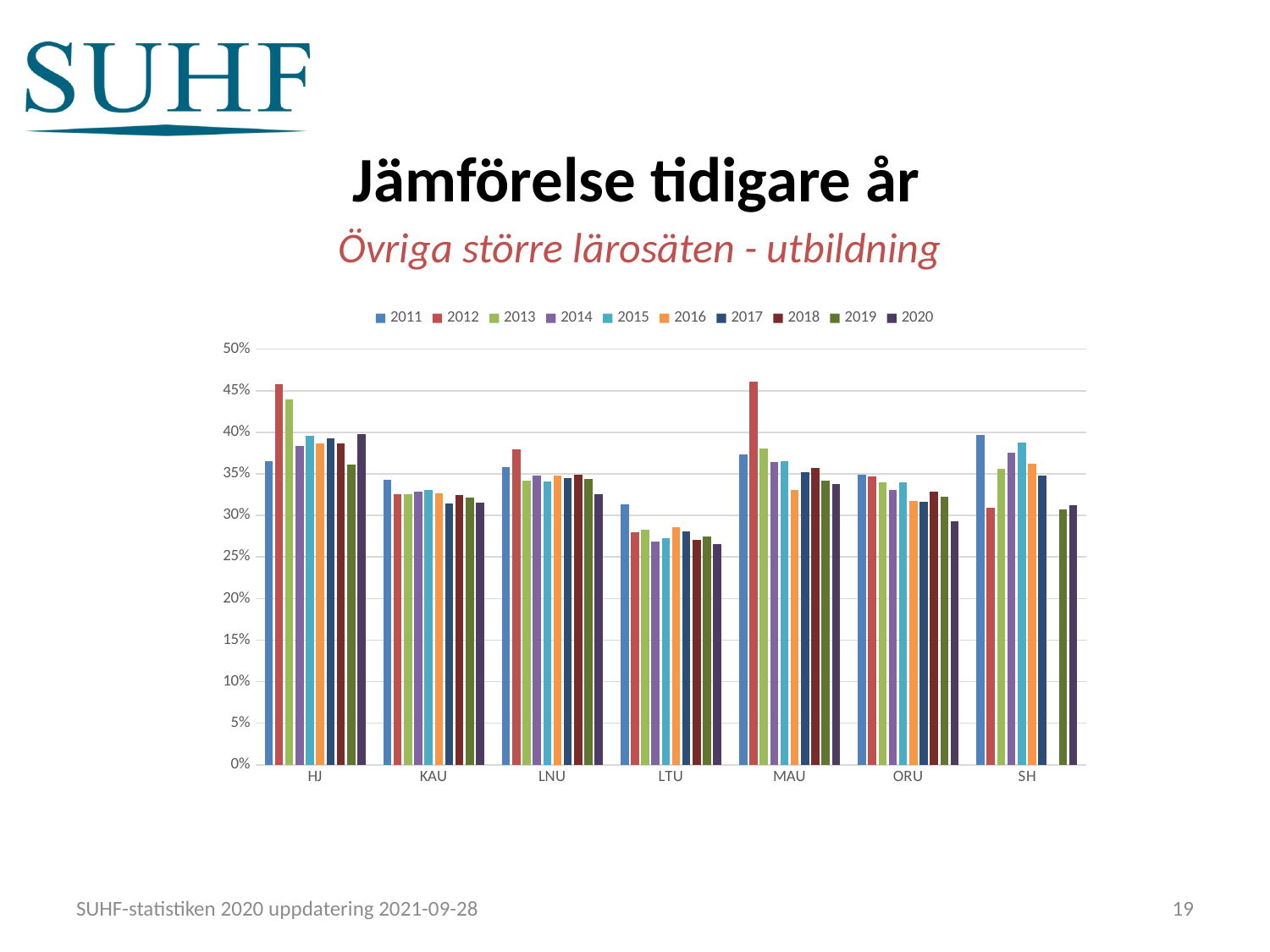
How many categories (lärosäten) are shown on the x axis of the chart? 7 For SH, which is larger: the 2011 value or the 2012 value? 2011 Is the value for LTU in 2011 greater or less than 30%? greater Is the value for MAU in 2012 greater or less than 45%? greater How many series does the chart legend list? 10 What is the subtitle shown in red italics above the chart? Övriga större lärosäten - utbildning Is the value for HJ in 2012 greater or less than 45%? greater Which category has the lowest value for 2020? LTU What kind of chart is shown on the slide? bar chart Which category has the lowest value for 2011? LTU